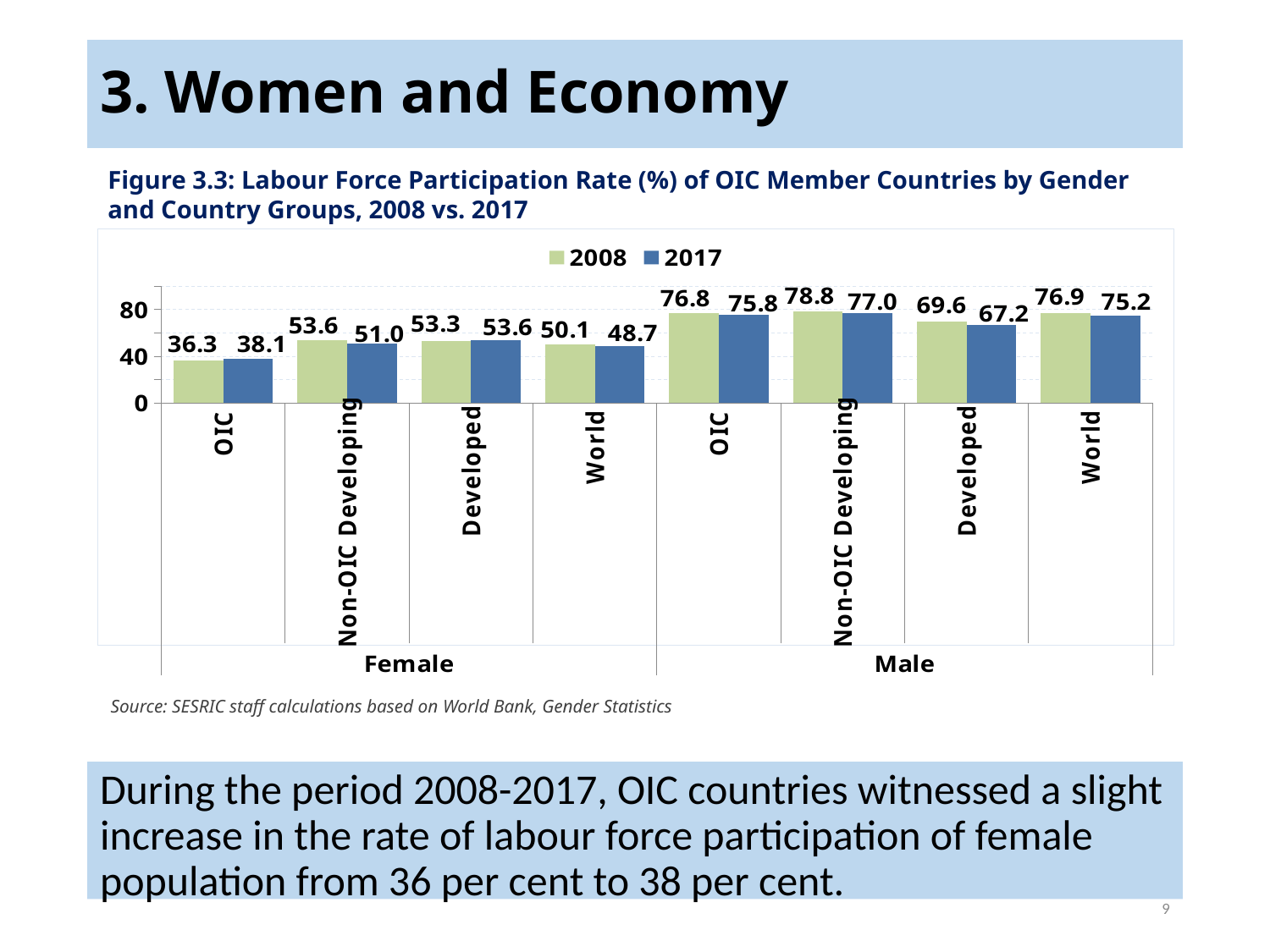
Which is larger: the 2017 female rate for Non-OIC Developing countries or the 2017 female rate for Developed countries? Developed (53.6) What was the male labour force participation rate for Non-OIC Developing countries in 2017? 77.0 Which category has the highest 2008 value in the chart? Male Non-OIC Developing Which category has the lowest 2017 value in the chart? Female OIC How many series does the legend list? 2 Is the 2008 male value for Developed countries greater or less than 80? less How many category groups are plotted along the x axis? 8 What is the difference between the 2008 and 2017 male labour force participation rates for Developed countries? 2.4 By how much did the female labour force participation rate for OIC countries change from 2008 to 2017? 1.8 What was the female labour force participation rate for OIC countries in 2008? 36.3 What kind of chart is shown on the slide? Bar chart What was the female labour force participation rate for the World in 2017? 48.7